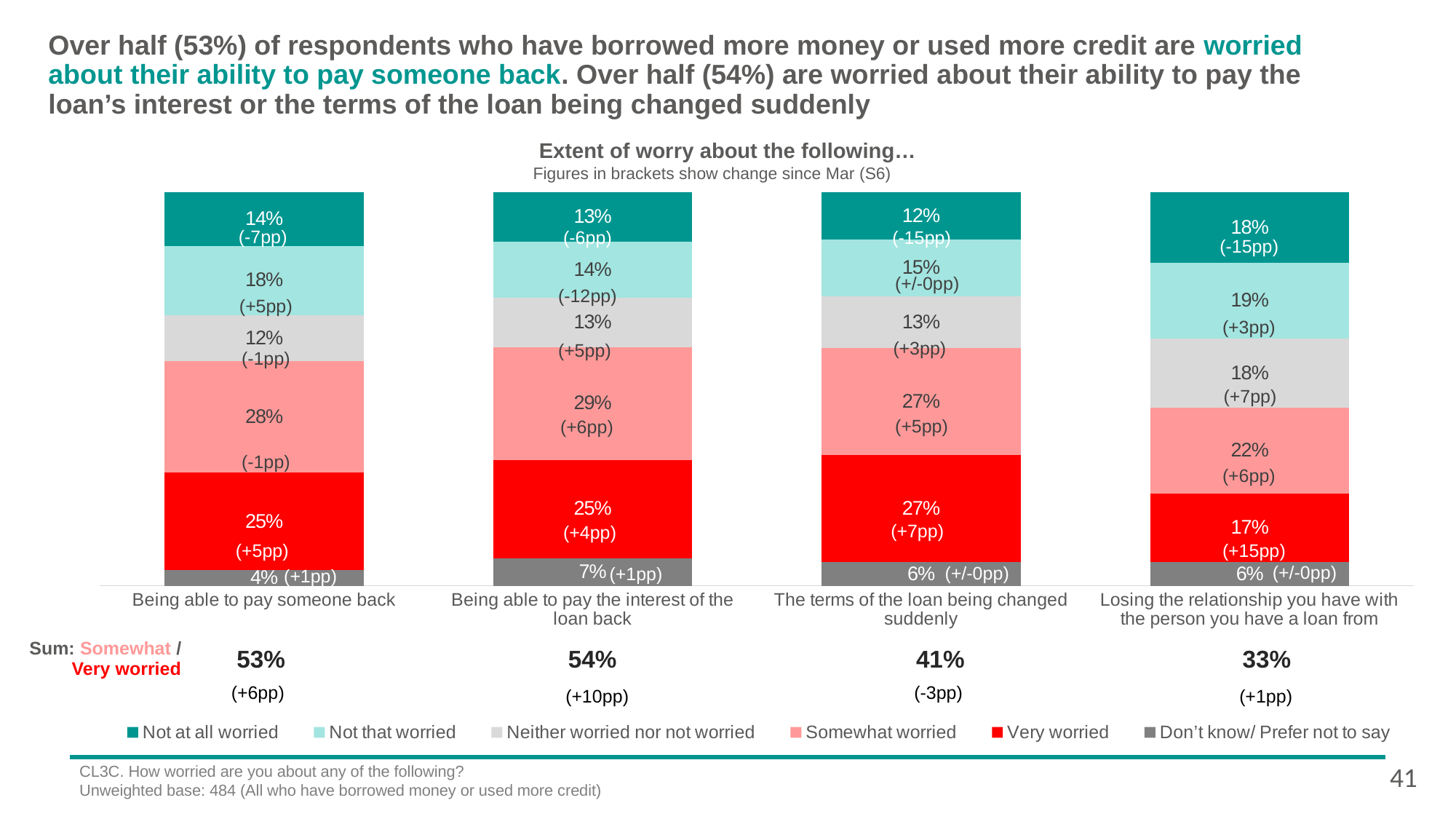
What kind of chart is shown on the slide? Stacked bar chart What percentage of respondents are very worried about being able to pay someone back? 25% What is the combined somewhat/very worried sum for being able to pay the interest of the loan back? 54% Which category has the highest share of respondents who are not at all worried? Losing the relationship you have with the person you have a loan from Which has a larger very worried share: the terms of the loan being changed suddenly or being able to pay the interest of the loan back? The terms of the loan being changed suddenly What is the difference in the somewhat worried share between being able to pay someone back and losing the relationship with the person you have a loan from? 6 percentage points How many series does the legend list? 6 How many categories (worry items) are shown in the chart? 4 Which category has the lowest share of respondents who are very worried? Losing the relationship you have with the person you have a loan from What percentage are somewhat worried about being able to pay the interest of the loan back? 29% What is the change since March shown for the very worried share for losing the relationship with the person you have a loan from? +15pp What percentage answered don't know/prefer not to say for being able to pay someone back? 4%